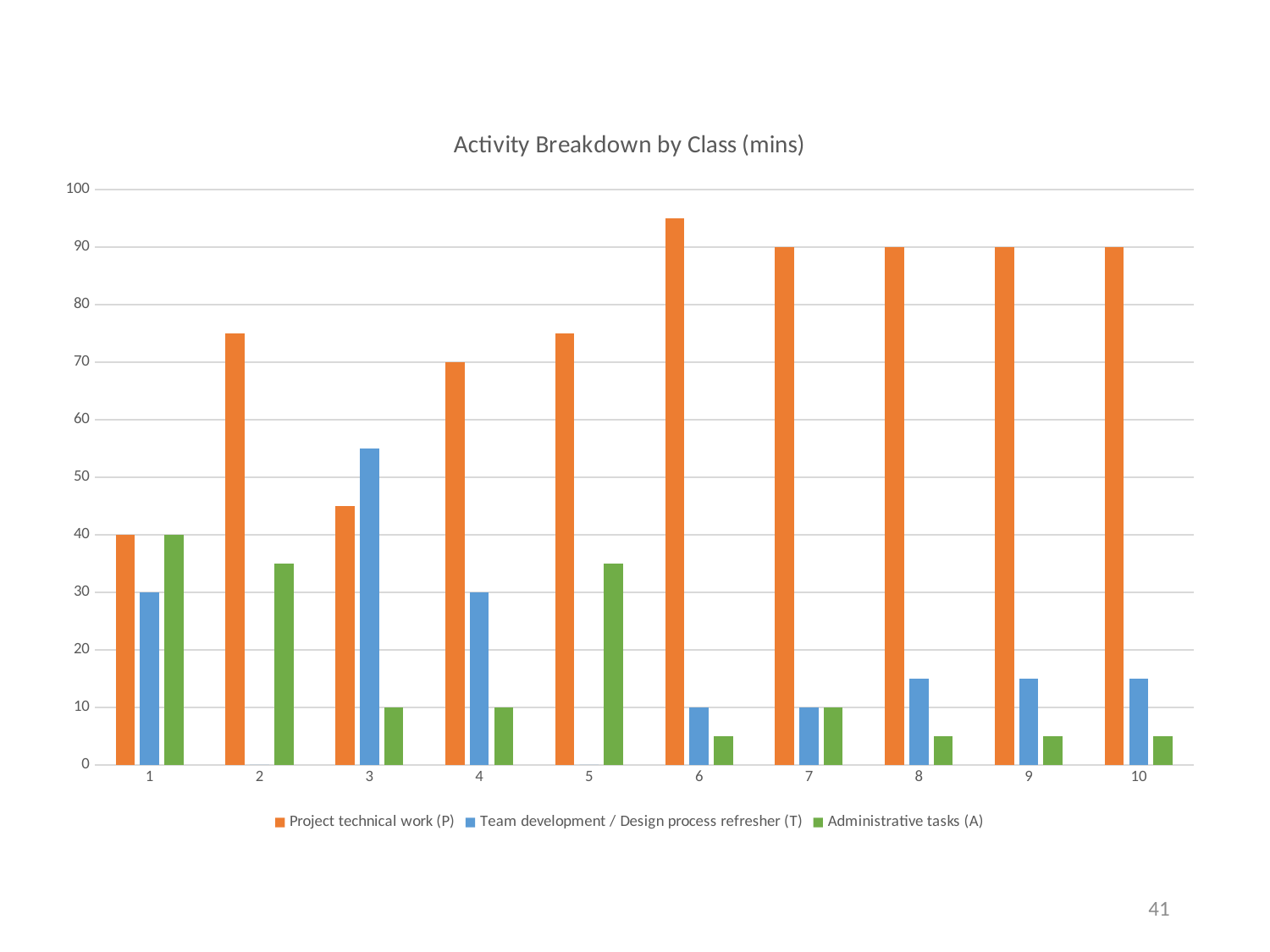
What type of chart is shown on the slide? Bar chart Is the value of Project technical work (P) for class 6 greater or less than 90? greater What is the value of Team development / Design process refresher (T) for class 1? 30 For which class is Project technical work (P) highest? 6 What is the value of Project technical work (P) for class 4? 70 What is the difference between Project technical work (P) for class 4 and for class 1? 30 What is the title of the chart? Activity Breakdown by Class (mins) How many classes are shown on the x axis? 10 How many series does the legend list? 3 For class 3, which is larger: Project technical work (P) or Team development / Design process refresher (T)? Team development / Design process refresher (T) For which class is Team development / Design process refresher (T) highest? 3 What is the value of Project technical work (P) for class 1? 40